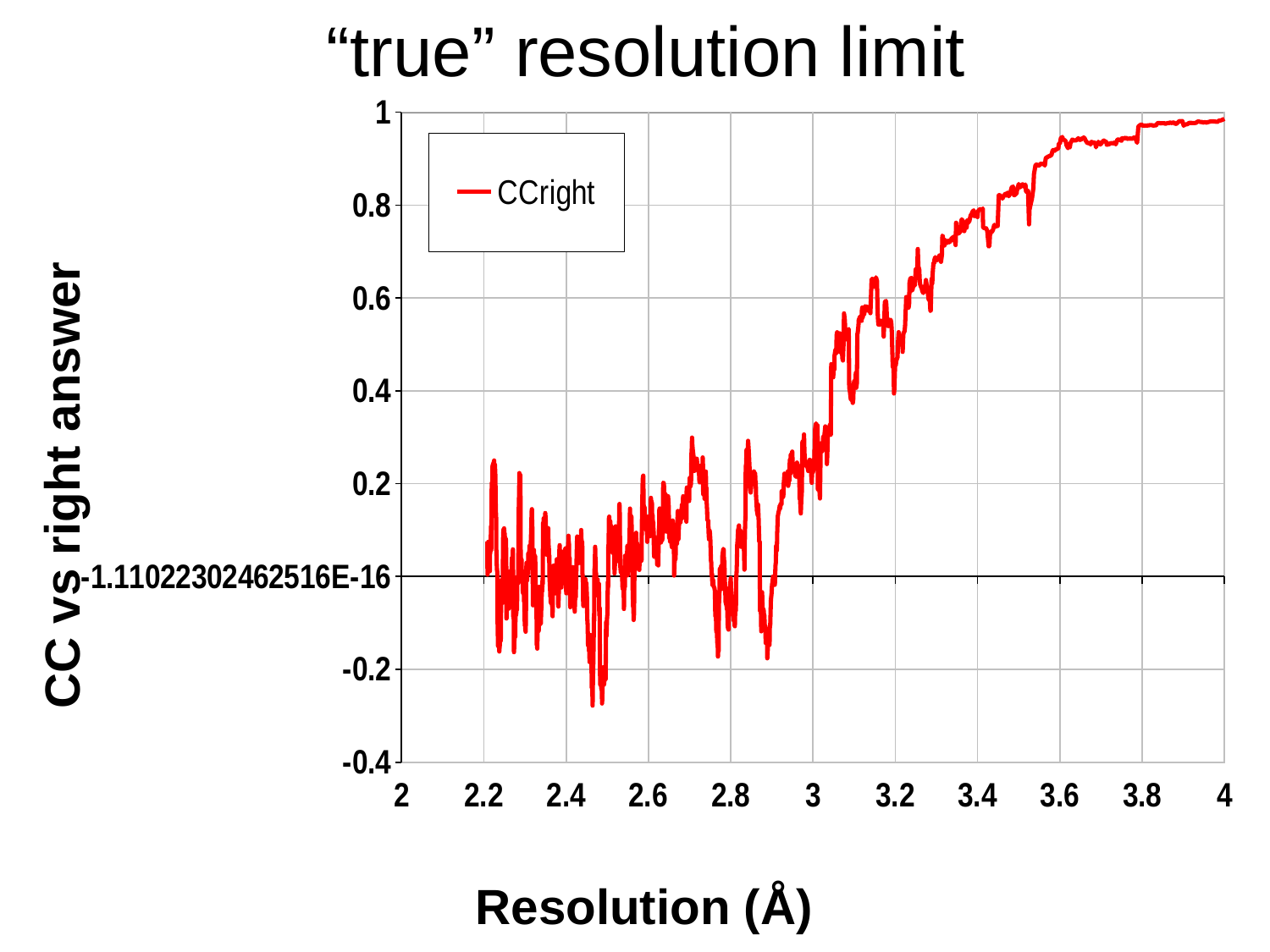
Is the CCright value at a resolution of 3.6 Å greater or less than 0.8? greater Is the CCright value at a resolution of 3 Å greater or less than 0.4? less Is the CCright value at a resolution of 4 Å greater or less than 0.8? greater What is the name of the series shown in the legend? CCright Overall, does the CCright value rise or fall as Resolution increases from 2.2 to 4 Å? rise Which of the two resolutions, 2.6 Å or 3.4 Å, has the larger CCright value? 3.4 Å What kind of chart is shown on the slide? line chart How many series does the legend list? 1 What is the label of the x axis? Resolution (Å)